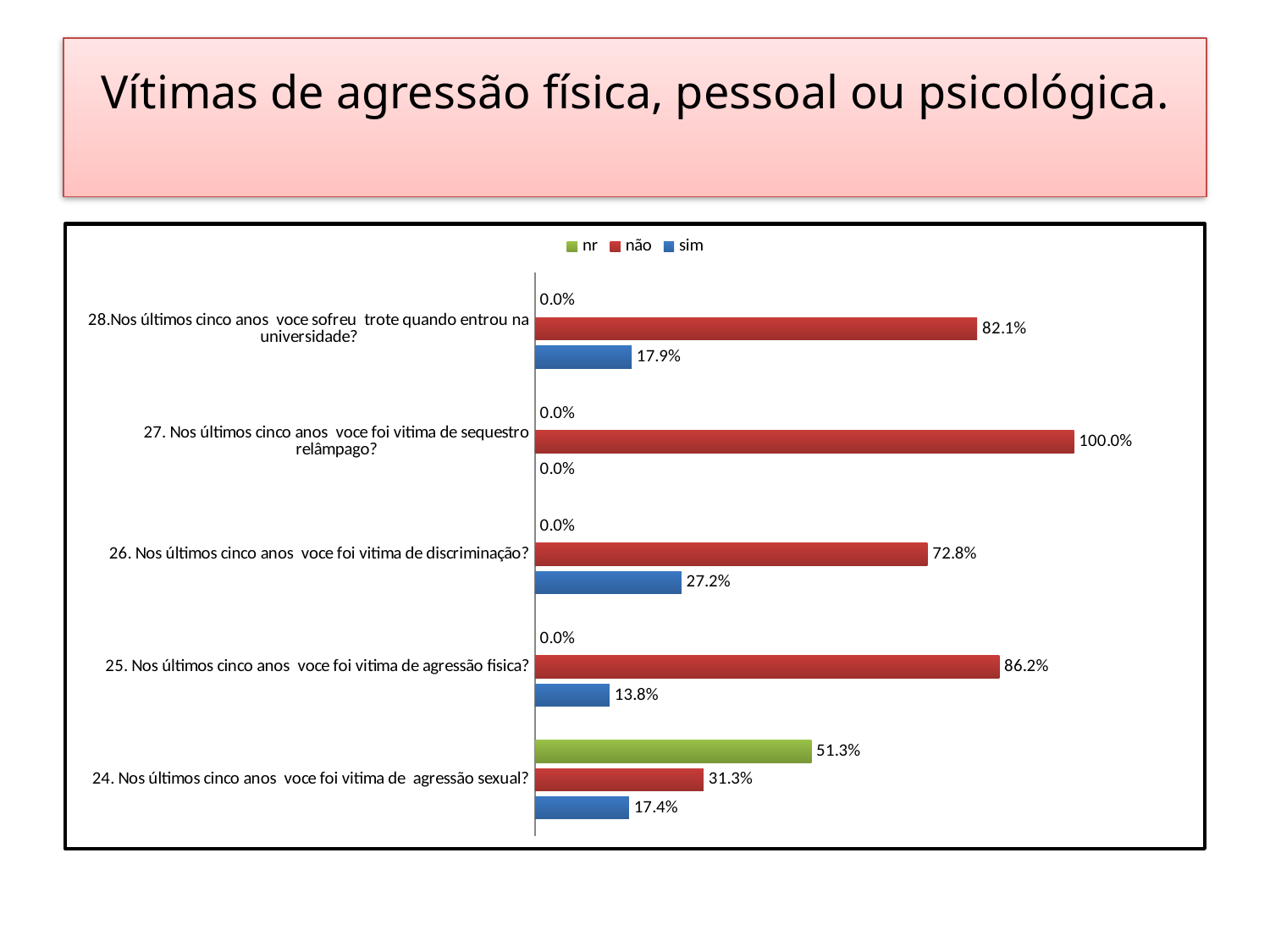
How many series does the legend list? 3 What is the difference between the 'não' and 'sim' values for question 28? 64.2% Which question has the lowest 'não' value? 24. Nos últimos cinco anos voce foi vitima de agressão sexual? What colour represents the 'sim' series in the chart? Blue Which question has the highest 'não' value? 27. Nos últimos cinco anos voce foi vitima de sequestro relâmpago? What is the 'nr' value for question 24 (vitima de agressão sexual)? 51.3% How many questions (categories) are shown on the chart? 5 What is the 'sim' value for question 26 (vitima de discriminação)? 27.2% What kind of chart is shown on the slide? Bar chart What is the 'não' value for question 28 (trote quando entrou na universidade)? 82.1% Which is larger for question 24: the 'nr' value or the 'não' value? nr What is the 'sim' value for question 25 (vitima de agressão fisica)? 13.8%